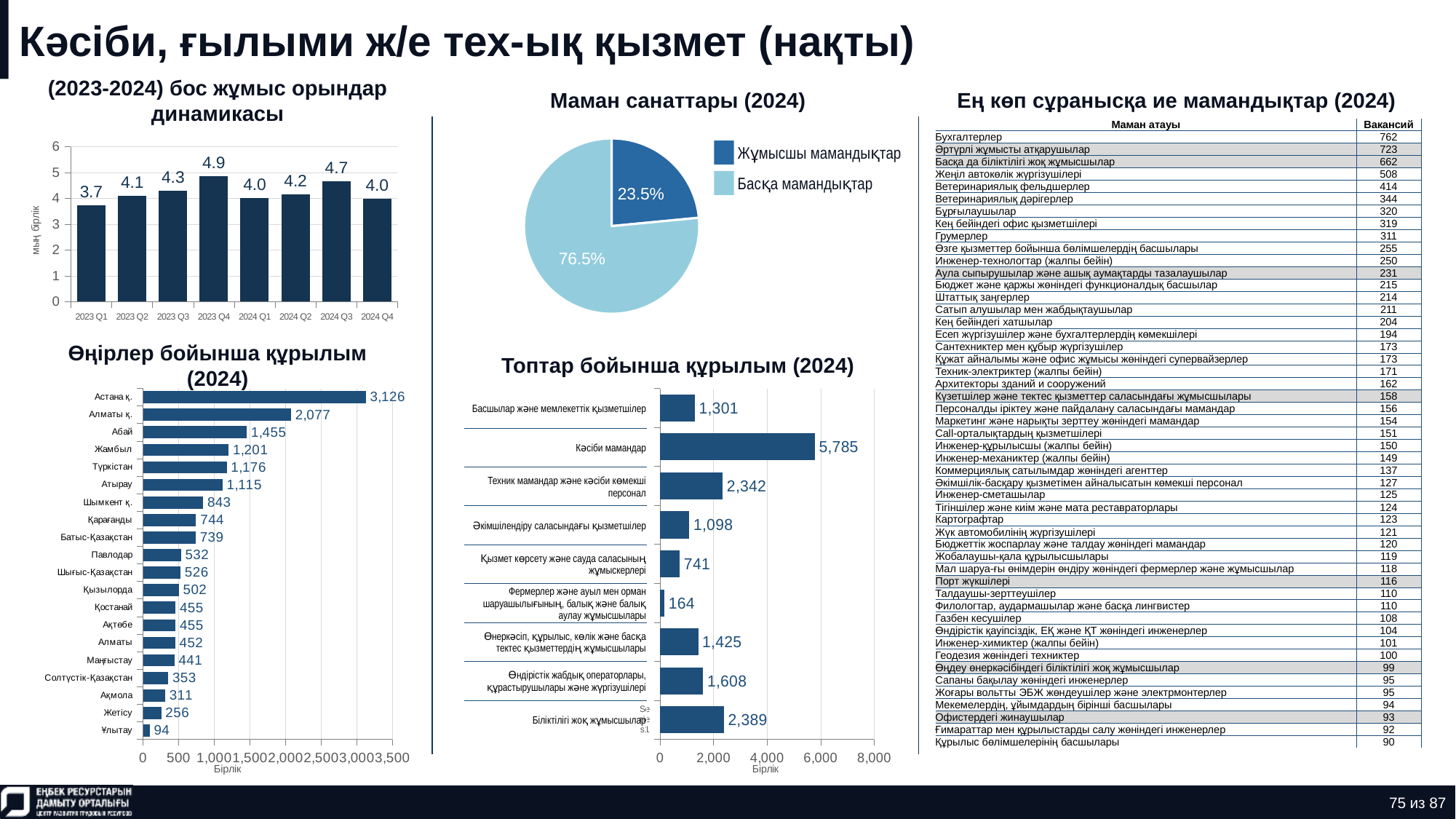
In the chart 'Топтар бойынша құрылым (2024)', which group has the lowest value? Фермерлер және ауыл мен орман шаруашылығының, балық және балық аулау жұмысшылары In the chart 'Өңірлер бойынша құрылым (2024)', what is the value for Абай? 1,455 In the chart '(2023-2024) бос жұмыс орындар динамикасы', which quarter has the lowest value? 2023 Q1 What kind of chart is 'Топтар бойынша құрылым (2024)'? Bar chart In the chart 'Топтар бойынша құрылым (2024)', what is the value for 'Кәсіби мамандар'? 5,785 In the chart '(2023-2024) бос жұмыс орындар динамикасы', what is the difference between 2024 Q3 and 2024 Q4? 0.7 In the chart '(2023-2024) бос жұмыс орындар динамикасы', how many bars are plotted? 8 In the pie chart 'Маман санаттары (2024)', how many entries does the legend list? 2 In the chart 'Өңірлер бойынша құрылым (2024)', how many regions are shown? 20 In the chart '(2023-2024) бос жұмыс орындар динамикасы', what is the value for 2023 Q4? 4.9 In the chart 'Өңірлер бойынша құрылым (2024)', which region has the highest value? Астана қ. In the pie chart 'Маман санаттары (2024)', what share is 'Жұмысшы мамандықтар'? 23.5%